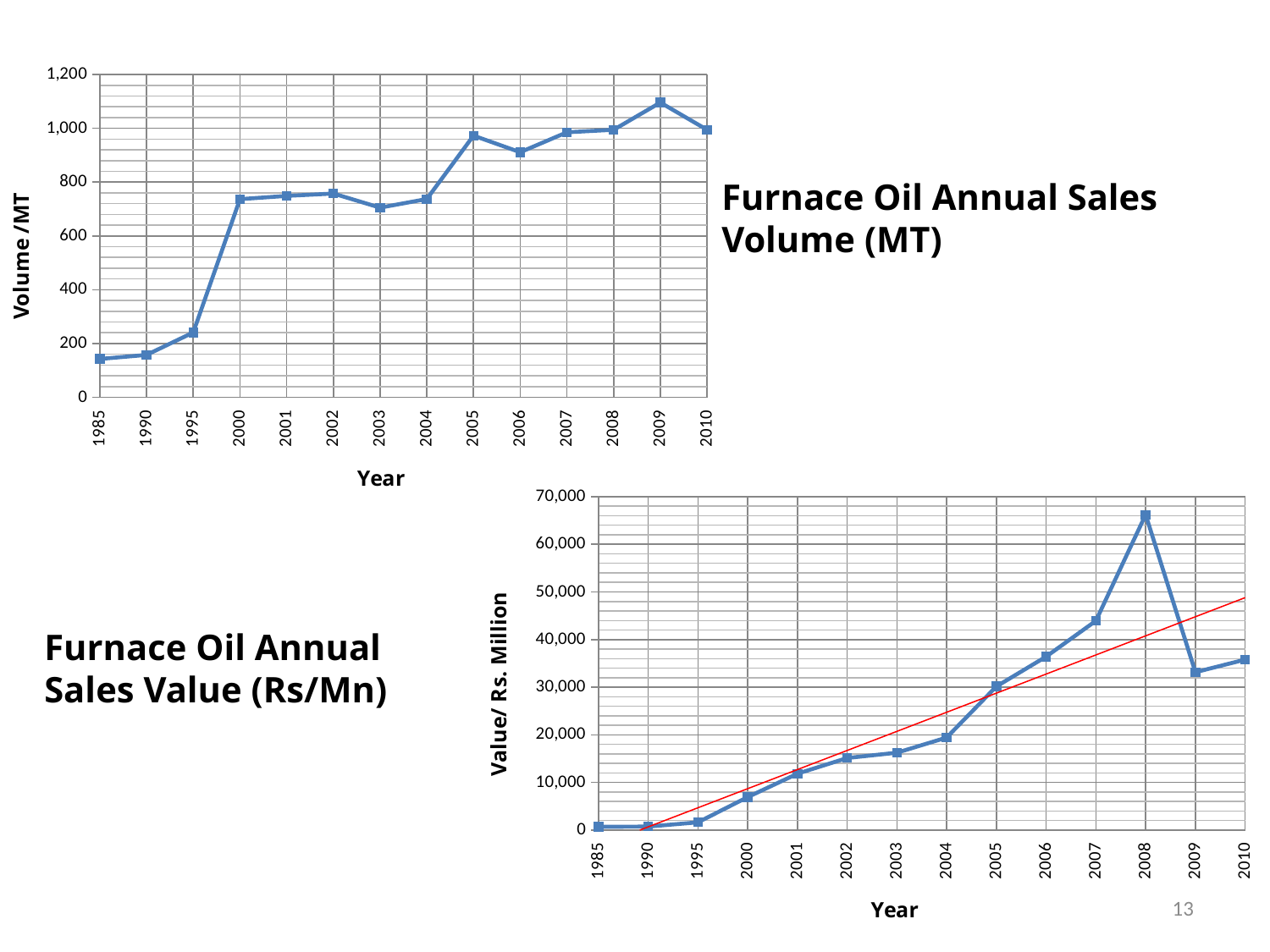
In the Furnace Oil Annual Sales Volume (MT) chart, is the value for 2009 greater or less than 1,000? greater How many years are plotted on the x axis of the Furnace Oil Annual Sales Volume (MT) chart? 14 What kind of chart is the Furnace Oil Annual Sales Volume (MT) chart? line chart In the Furnace Oil Annual Sales Value (Rs/Mn) chart, which year has the highest sales value? 2008 What kind of chart is the Furnace Oil Annual Sales Value (Rs/Mn) chart? line chart In the Furnace Oil Annual Sales Value (Rs/Mn) chart, which year has the larger value, 2007 or 2009? 2007 What is the y-axis title of the Furnace Oil Annual Sales Value (Rs/Mn) chart? Value/ Rs. Million In the Furnace Oil Annual Sales Volume (MT) chart, which year has the lowest sales volume? 1985 In the Furnace Oil Annual Sales Volume (MT) chart, which year has the larger value, 2003 or 2005? 2005 In the Furnace Oil Annual Sales Volume (MT) chart, which year has the highest sales volume? 2009 In the Furnace Oil Annual Sales Value (Rs/Mn) chart, is the value for 2008 greater or less than 60,000? greater In the Furnace Oil Annual Sales Volume (MT) chart, is the value for 1995 greater or less than 400? less